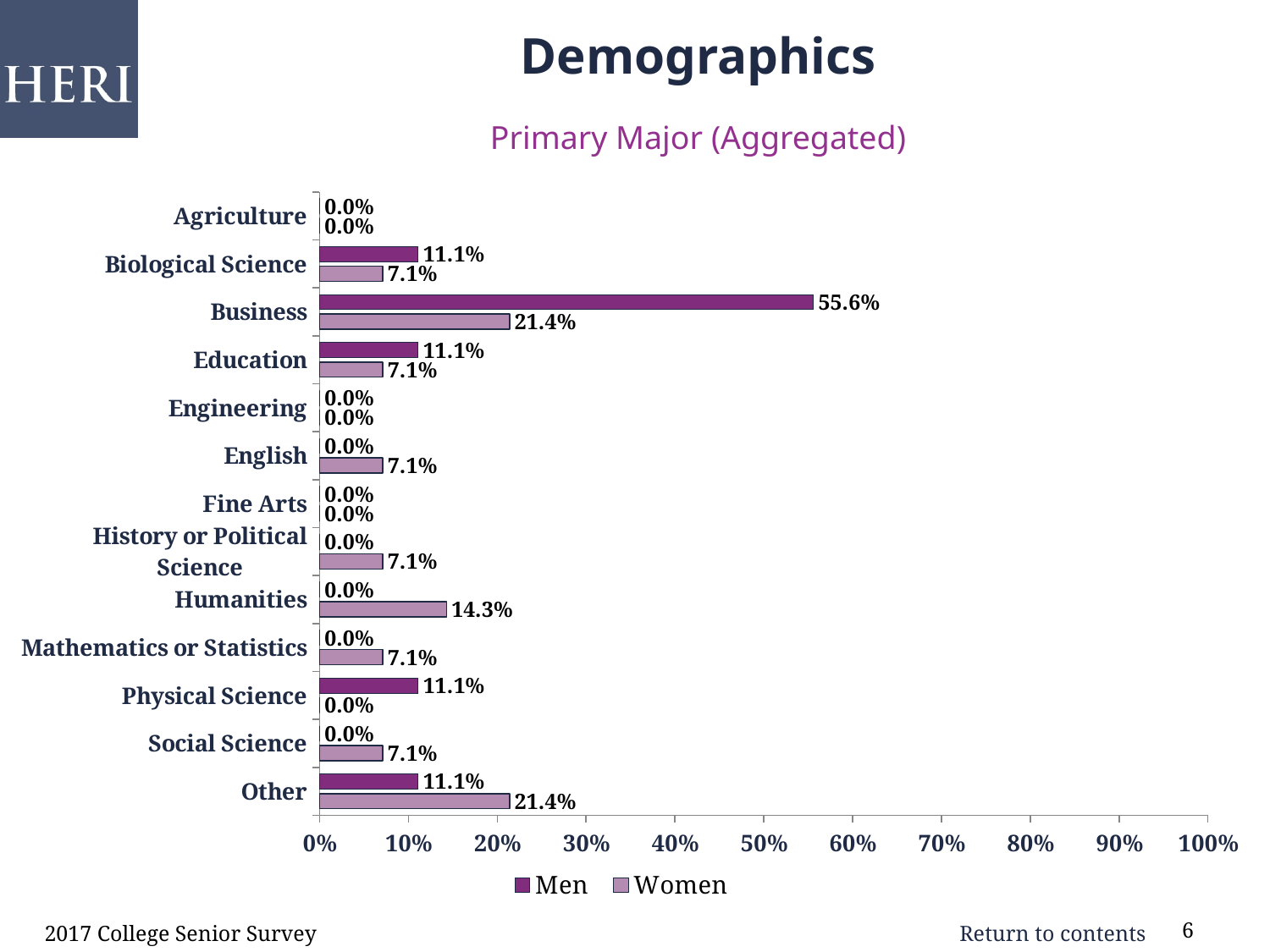
What is the value for Men in Business? 55.6% What is the difference between the Men and Women values for Business? 34.2% What is the title of the chart? Primary Major (Aggregated) What is the value for Women in Humanities? 14.3% How many categories are shown on the chart? 13 Which category has the highest value for Men? Business How many series does the legend list? 2 Is the value for Men in Business greater or less than 50%? greater Which is larger for Biological Science, the Men value or the Women value? Men What is the value for Women in Other? 21.4% What kind of chart is shown on the slide? Bar chart What is the value for Men in Physical Science? 11.1%